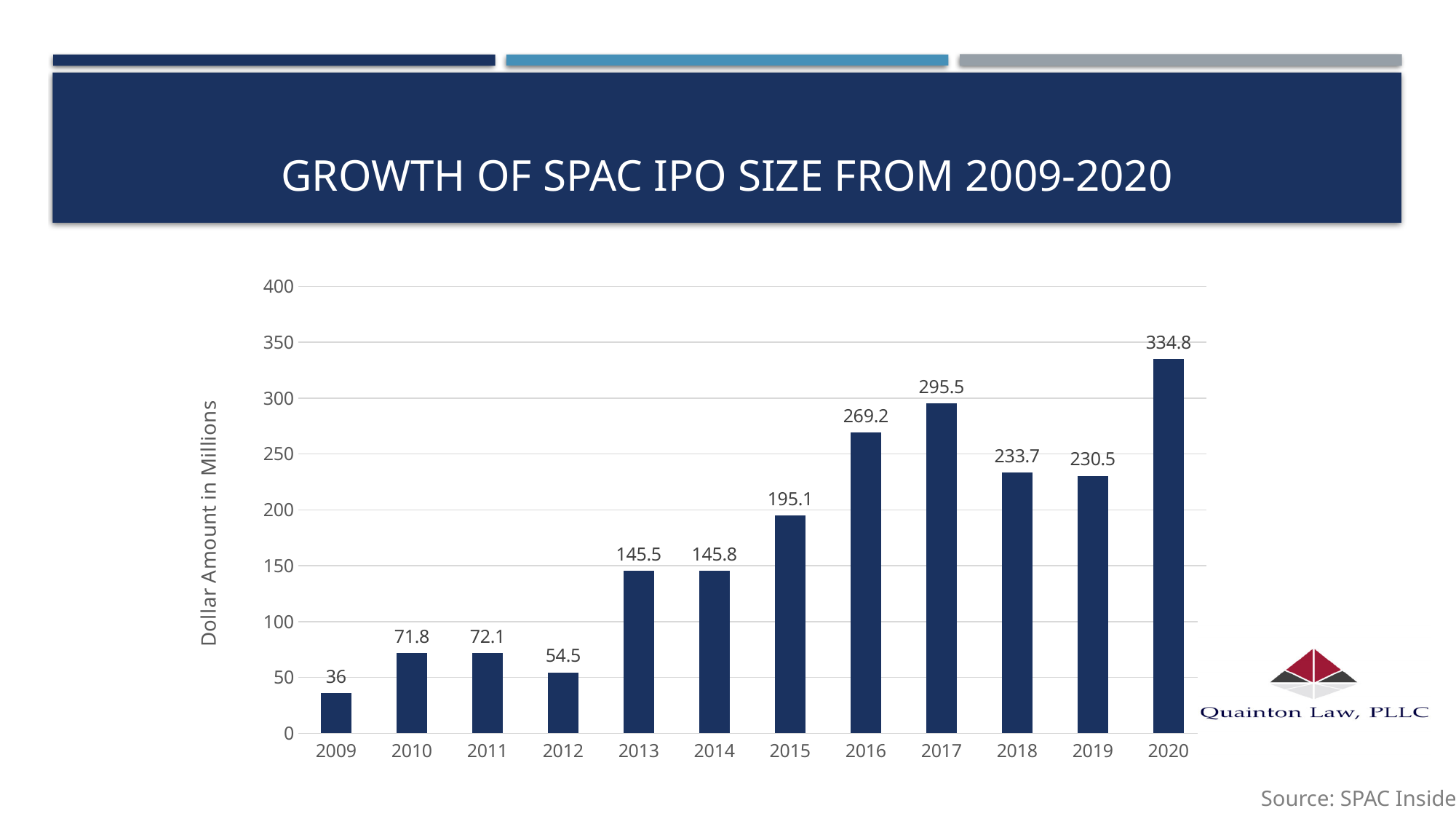
Is the value for 2017 greater or less than 250? greater What kind of chart is shown on the slide? Bar chart What is the difference between the values for 2018 and 2019? 3.2 How many years are shown on the x axis? 12 What is the value for 2016? 269.2 What is the label of the vertical axis? Dollar Amount in Millions Which year has the lowest value? 2009 Which is larger, the value for 2015 or the value for 2018? 2018 What is the value for 2019? 230.5 What is the difference between the values for 2020 and 2017? 39.3 What is the value for 2009? 36 Which year has the highest value? 2020